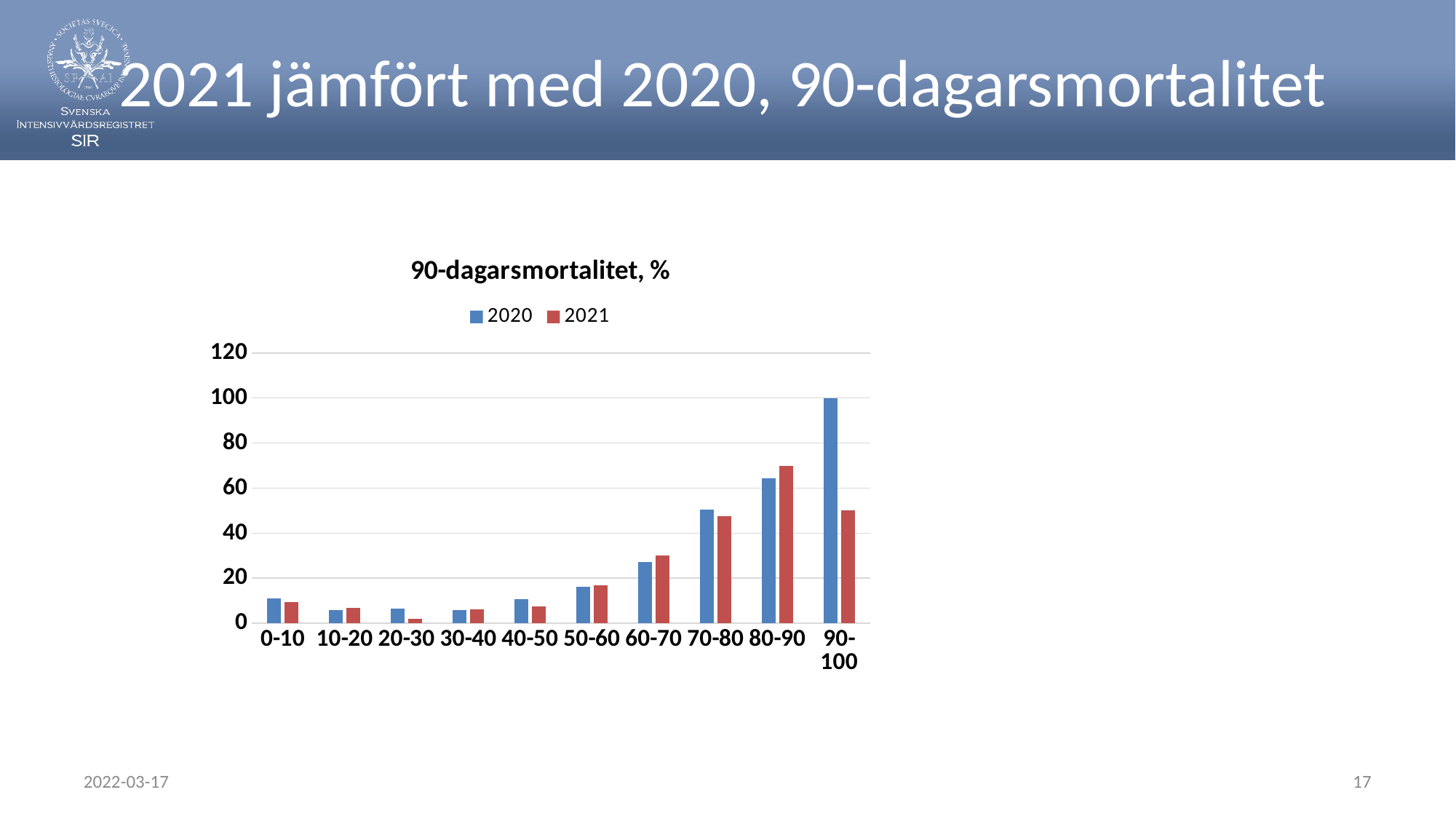
Which age group has the highest 2021 value? 80-90 What is the 2020 value for the 90-100 age group? 100 Which age group has the lowest 2021 value? 20-30 What is the title of the chart? 90-dagarsmortalitet, % How many age categories are shown on the x axis? 10 Is the 2021 value for the 80-90 age group greater or less than 60? greater Which colour represents the 2021 series in the chart? red Which age group has the highest 2020 value? 90-100 For the 90-100 age group, which series has the larger value, 2020 or 2021? 2020 What type of chart is shown on the slide? bar chart How many series does the legend list? 2 Is the 2020 value for the 60-70 age group greater or less than 40? less